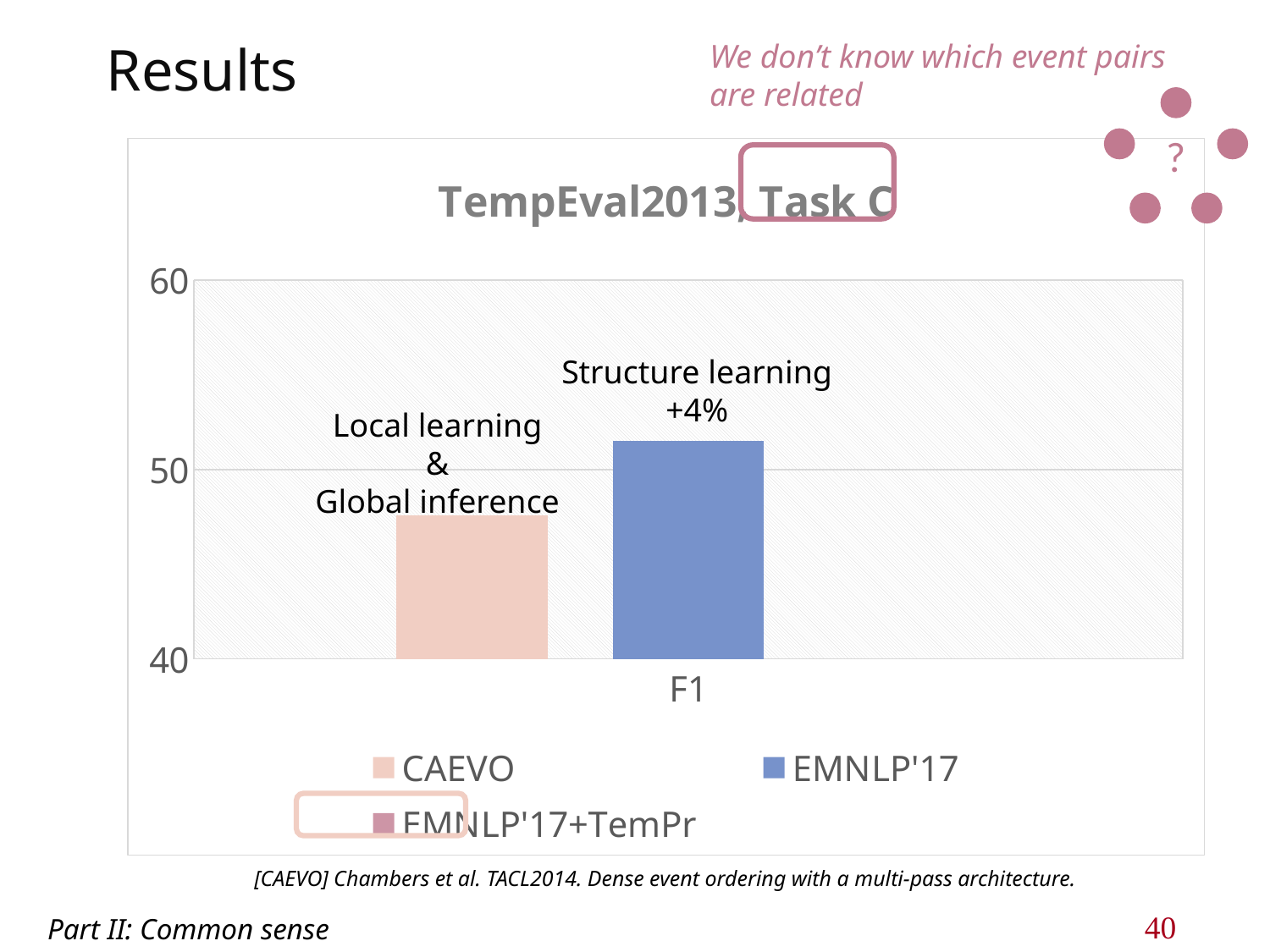
What kind of chart is shown on the slide? bar chart Is the F1 value for EMNLP'17 greater or less than 50? greater Is the F1 value for CAEVO greater or less than 50? less What is the title of the chart? TempEval2013, Task C What improvement does the annotation above the EMNLP'17 bar state for structure learning? +4% Is the F1 value for CAEVO greater or less than 40? greater Which of the plotted bars is the tallest? EMNLP'17 Which is larger for F1, the CAEVO bar or the EMNLP'17 bar? EMNLP'17 How many categories are shown on the x axis of the chart? 1 How many series does the chart legend list? 3 What is the label of the category on the x axis? F1